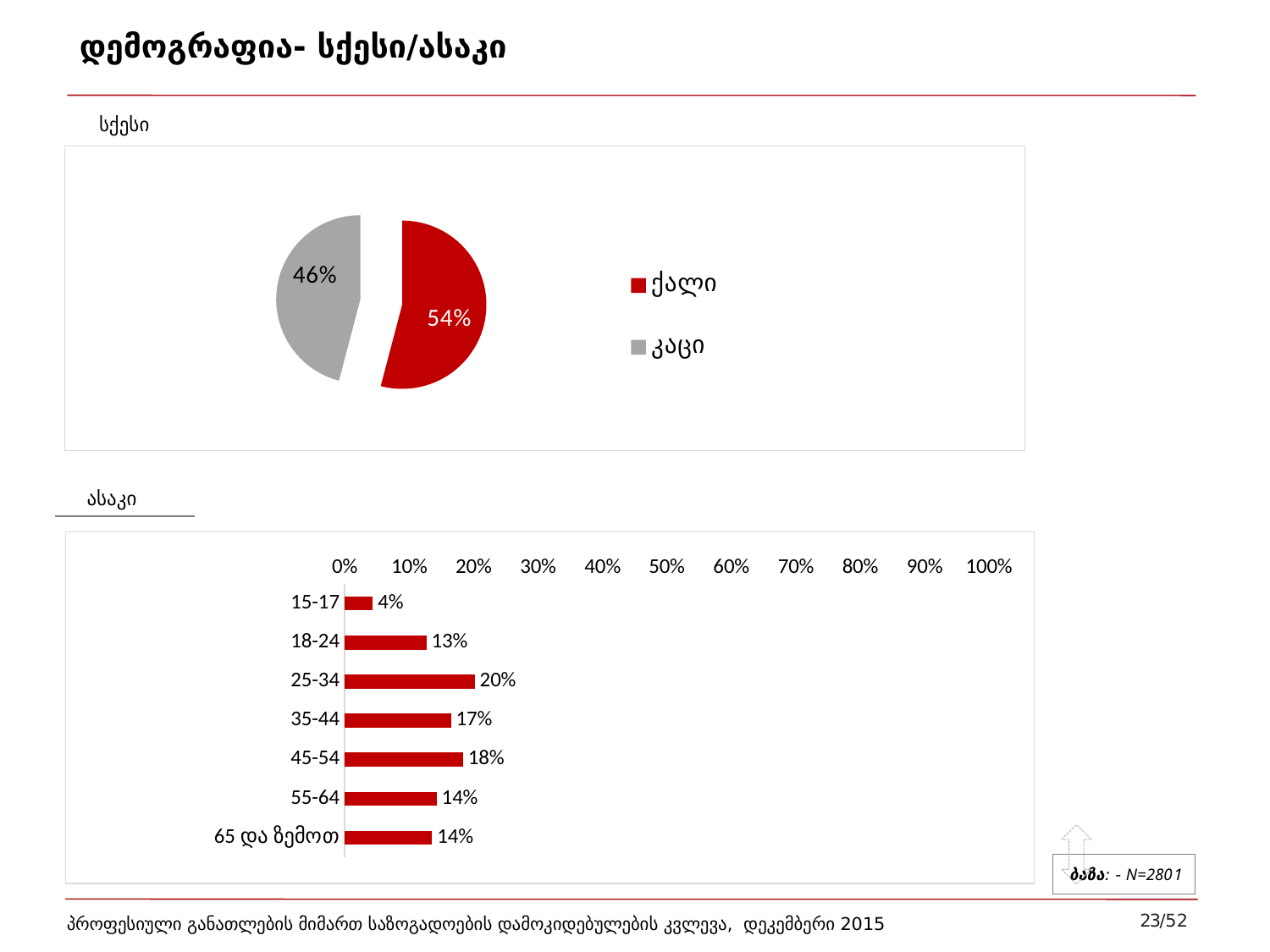
In the bar chart at the bottom of the slide (ასაკი), which age group has the lowest value? 15-17 In the pie chart at the top of the slide (სქესი), which slice is larger, ქალი or კაცი? ქალი In the pie chart at the top of the slide (სქესი), what share is shown for ქალი? 54% In the pie chart at the top of the slide (სქესი), what share is shown for კაცი? 46% In the bar chart at the bottom of the slide (ასაკი), what is the value for 25-34? 20% In the bar chart at the bottom of the slide (ასაკი), which age group has the highest value? 25-34 In the bar chart at the bottom of the slide (ასაკი), which is larger, the value for 45-54 or the value for 55-64? 45-54 What kind of chart is the lower chart on the slide (ასაკი)? bar chart In the bar chart at the bottom of the slide (ასაკი), what is the difference between the values for 25-34 and 18-24? 7% In the pie chart at the top of the slide (სქესი), how many entries does the legend list? 2 In the bar chart at the bottom of the slide (ასაკი), what is the value for 15-17? 4% In the bar chart at the bottom of the slide (ასაკი), how many age categories are shown? 7